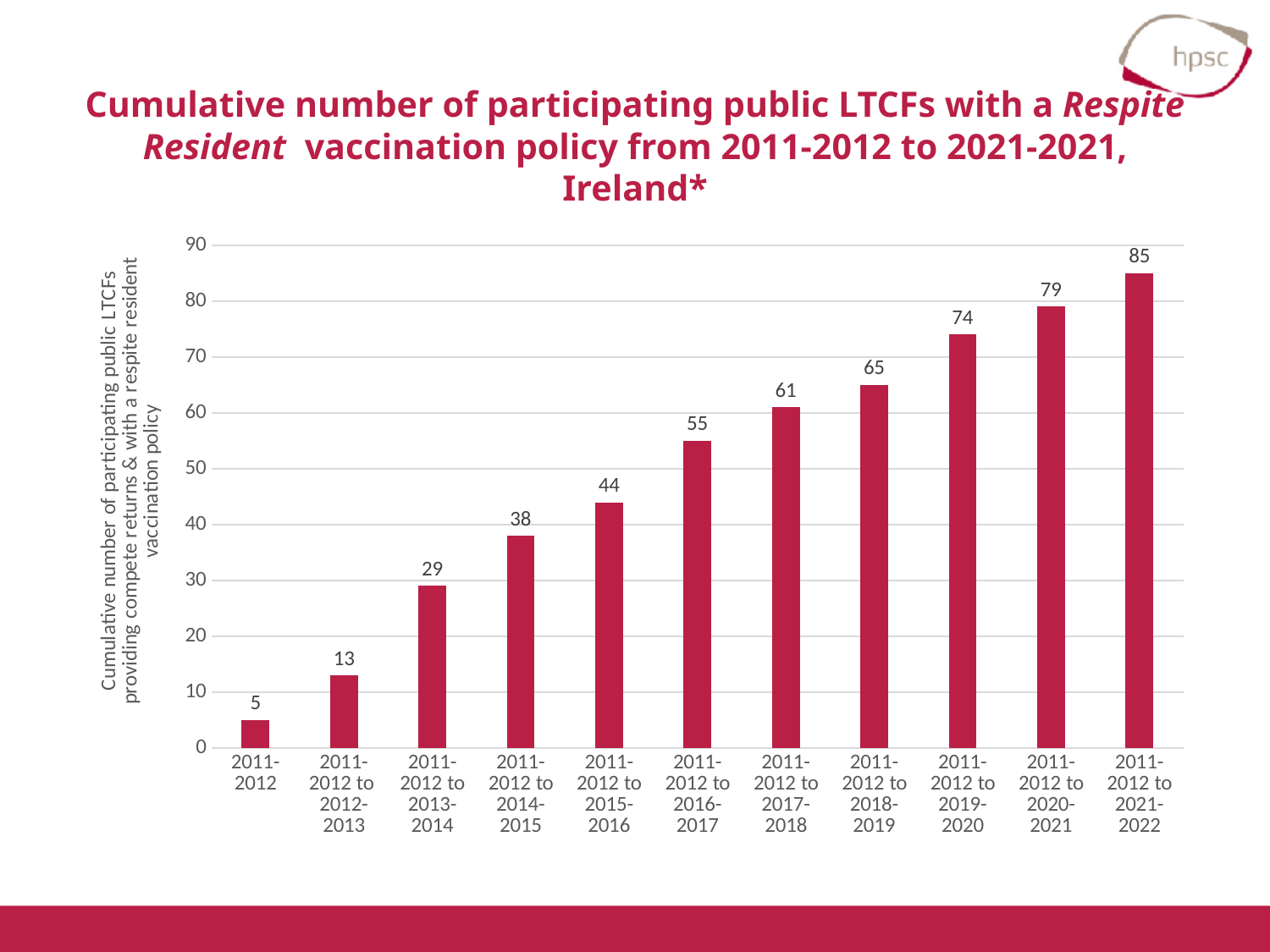
What is the cumulative number of participating public LTCFs with a respite resident vaccination policy for 2011-2012 to 2016-2017? 55 Do the values rise or fall along the x axis? rise By how much did the cumulative number increase from 2011-2012 to 2011-2012 to 2012-2013? 8 Is the value for 2011-2012 to 2017-2018 greater or less than 60? greater Which is larger, the value for 2011-2012 to 2014-2015 or the value for 2011-2012 to 2015-2016? 2011-2012 to 2015-2016 What is the difference between the values for 2011-2012 to 2021-2022 and 2011-2012 to 2020-2021? 6 What kind of chart is shown on the slide? bar chart How many categories are shown on the x axis? 11 What is the value for 2011-2012 to 2019-2020? 74 Which category has the highest value? 2011-2012 to 2021-2022 What value is shown for the 2011-2012 category? 5 Which category has the lowest value? 2011-2012